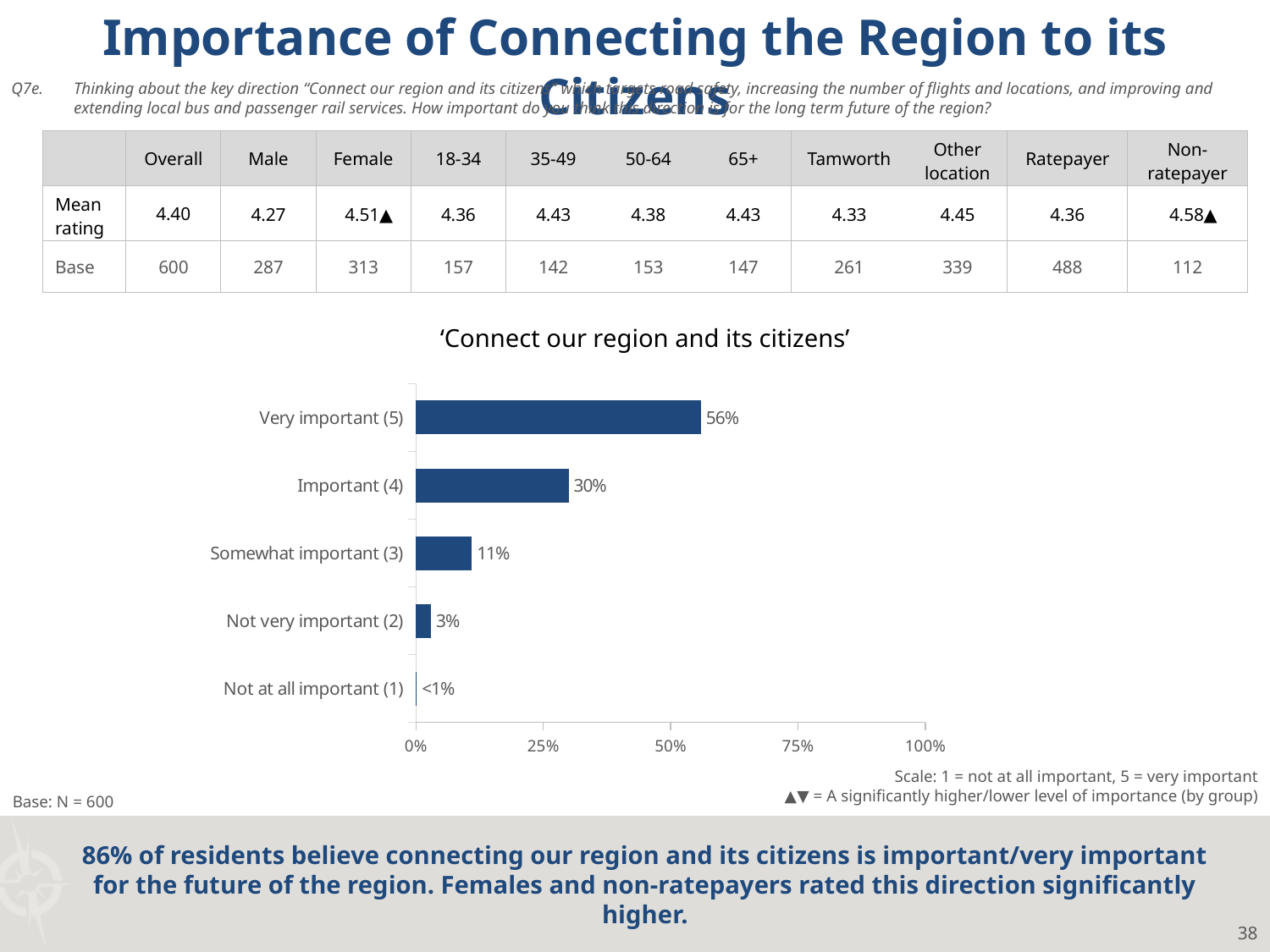
What is the value for Somewhat important (3)? 11% What kind of chart is shown? bar chart Which category has the lowest value? Not at all important (1) What is the value for Not very important (2)? 3% Is the value for Very important (5) greater or less than 50%? greater What is the difference between Very important (5) and Important (4)? 26% What is the value for Very important (5)? 56% What is the value shown for Not at all important (1)? <1% Which category has the highest value? Very important (5) Which is larger, Somewhat important (3) or Not very important (2)? Somewhat important (3) How many categories are shown in the chart? 5 What is the value for Important (4)? 30%